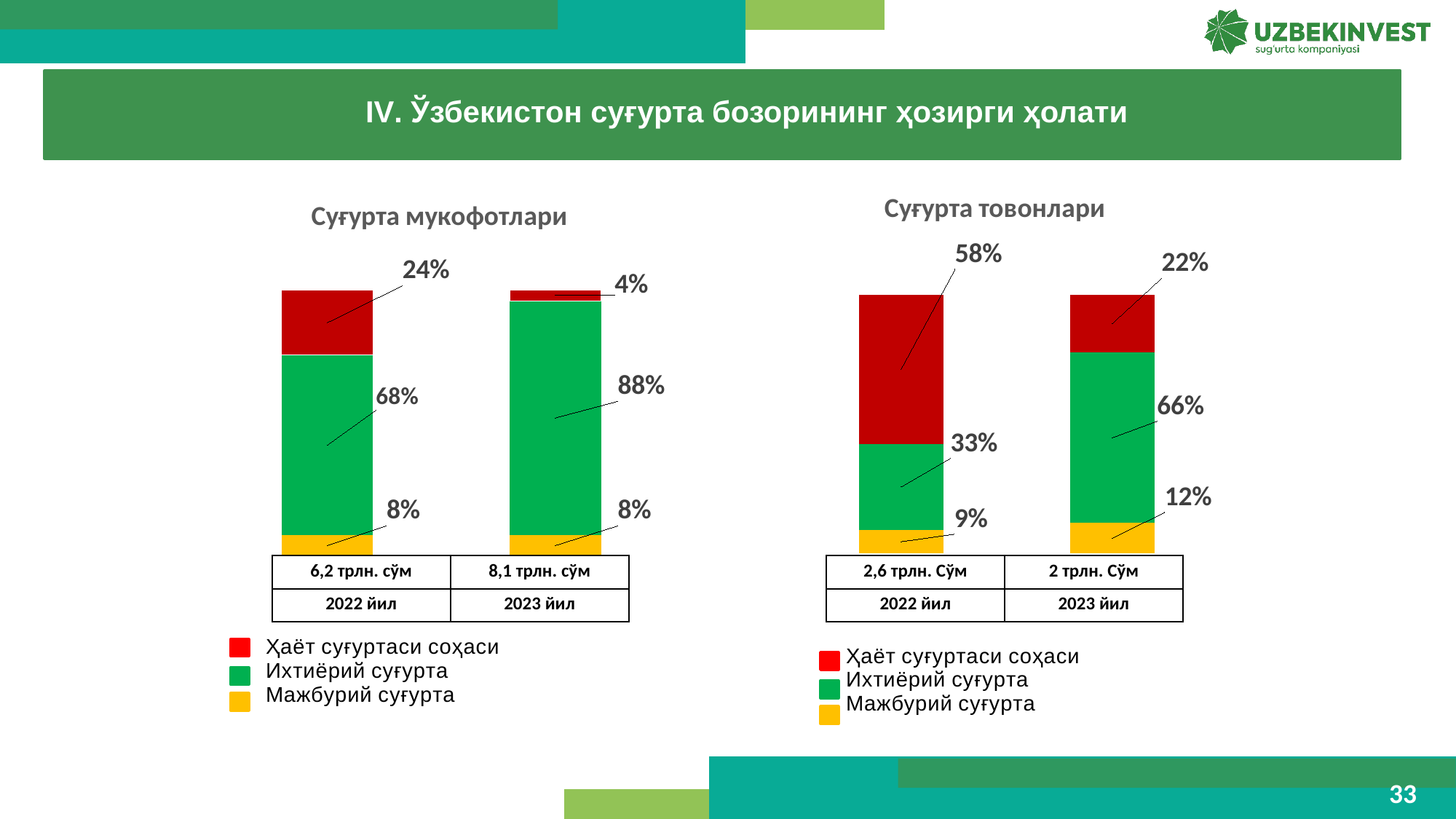
In the "Суғурта мукофотлари" chart, what total value is shown under the 2023 йил bar? 8,1 трлн. сўм What kind of chart is the "Суғурта товонлари" chart? Stacked bar chart In the "Суғурта товонлари" chart, is the Ихтиёрий суғурта share larger in 2022 йил or 2023 йил? 2023 йил In the "Суғурта мукофотлари" chart, by how many percentage points did the Ҳаёт суғуртаси соҳаси share fall from 2022 йил to 2023 йил? 20 percentage points How many series does the legend of the "Суғурта мукофотлари" chart list? 3 In the "Суғурта товонлари" chart, what is the difference between the Ихтиёрий суғурта shares in 2023 йил and 2022 йил? 33 percentage points In the "Суғурта товонлари" chart, what share does Ҳаёт суғуртаси соҳаси have in 2022 йил? 58% In the "Суғурта товонлари" chart, which segment is largest in 2022 йил? Ҳаёт суғуртаси соҳаси In the "Суғурта мукофотлари" chart, which segment is smallest in 2023 йил? Ҳаёт суғуртаси соҳаси In the "Суғурта мукофотлари" chart, what share does Ҳаёт суғуртаси соҳаси have in 2022 йил? 24% In the "Суғурта мукофотлари" chart, what share does Ихтиёрий суғурта have in 2023 йил? 88% In the "Суғурта товонлари" chart, what share does Мажбурий суғурта have in 2023 йил? 12%